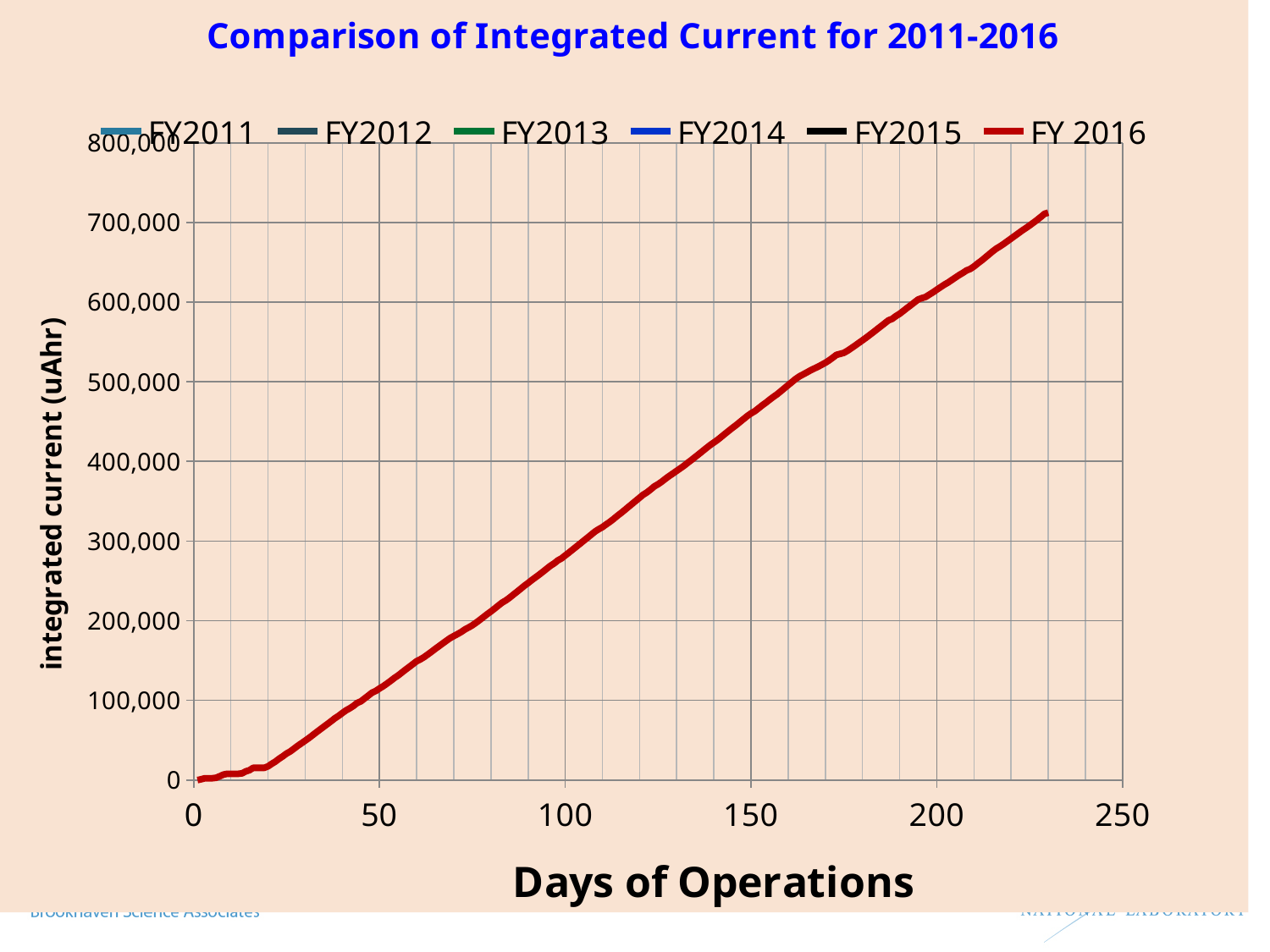
Does the FY 2016 line rise or fall as Days of Operations increase? rise Is the FY 2016 value at 200 days of operations greater or less than 600,000? greater What is the label of the x axis? Days of Operations Is the highest FY 2016 value plotted greater or less than 700,000? greater Is the FY 2016 value at 50 days of operations greater or less than 100,000? greater What is the title of the chart? Comparison of Integrated Current for 2011-2016 What kind of chart is shown on the slide? line chart How many series does the legend list? 6